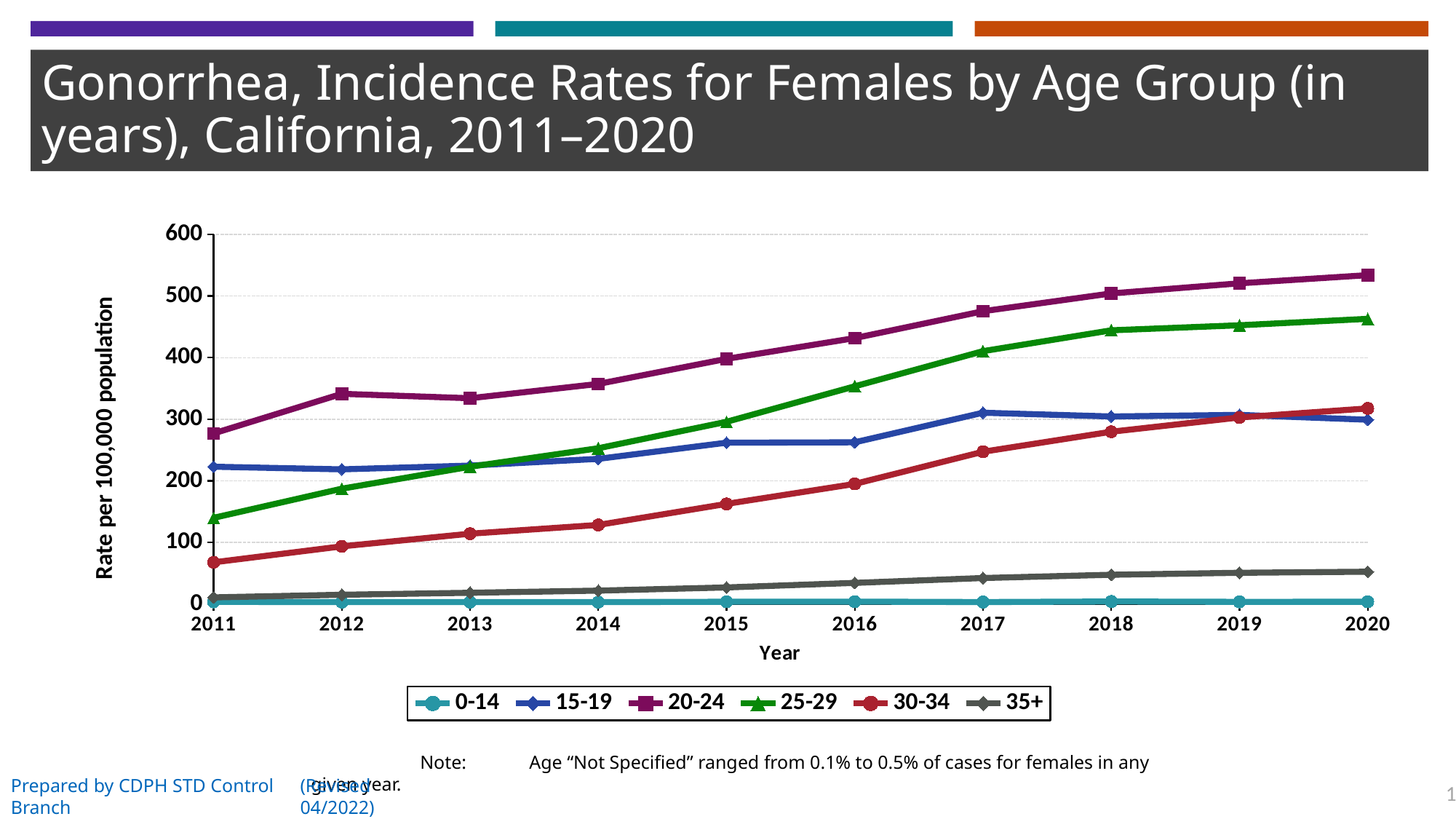
How many years are plotted along the x axis? 10 In 2016, which age group has the higher rate, 15-19 or 30-34? 15-19 Does the rate for the 20-24 age group rise or fall from 2011 to 2020? rise Which age group has the lowest incidence rate in 2020? 0-14 What kind of chart is shown on the slide? line chart Is the value for the 20-24 age group in 2020 greater or less than 500? greater How many age-group series does the legend list? 6 Is the value for the 35+ age group in 2020 greater or less than 100? less Is the value for the 25-29 age group in 2011 greater or less than 200? less What is the label of the y axis? Rate per 100,000 population Which age group has the highest incidence rate in 2020? 20-24 In 2014, which age group has the higher rate, 20-24 or 25-29? 20-24